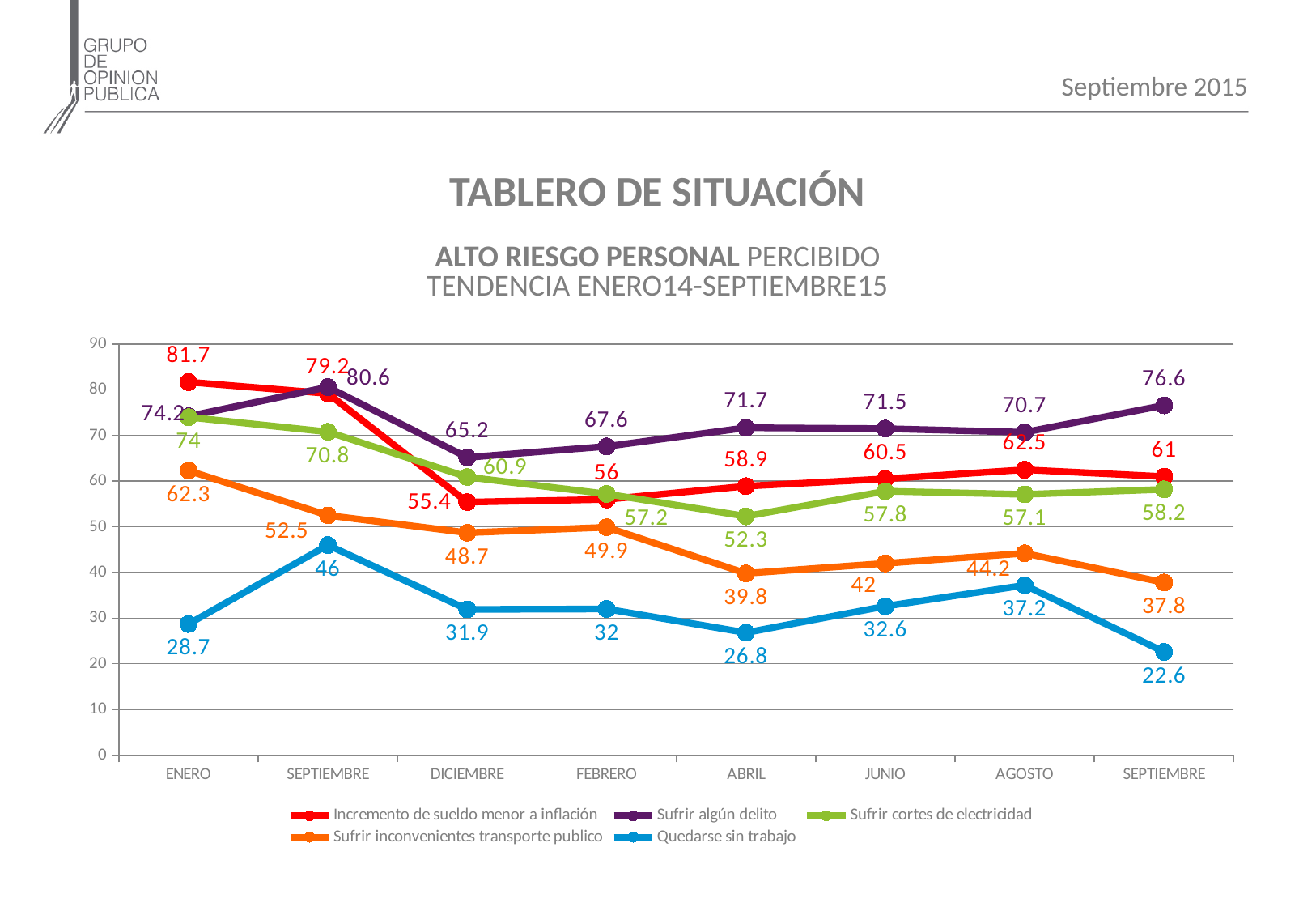
What is the value for Quedarse sin trabajo in ABRIL? 26.8 What kind of chart is shown on the slide? line chart How many time points are shown on the x axis? 8 Is the value for Quedarse sin trabajo in AGOSTO greater or less than 40? less What is the value for Sufrir cortes de electricidad in AGOSTO? 57.1 In which month does Incremento de sueldo menor a inflación reach its highest value? ENERO What is the value for Sufrir algún delito in FEBRERO? 67.6 How many series does the legend list? 5 Does the Sufrir inconvenientes transporte publico line rise or fall from ENERO to DICIEMBRE? fall What is the difference between the Sufrir inconvenientes transporte publico values in ENERO and DICIEMBRE? 13.6 In which month does Sufrir cortes de electricidad reach its lowest value? ABRIL In JUNIO, which is larger: Sufrir algún delito or Incremento de sueldo menor a inflación? Sufrir algún delito